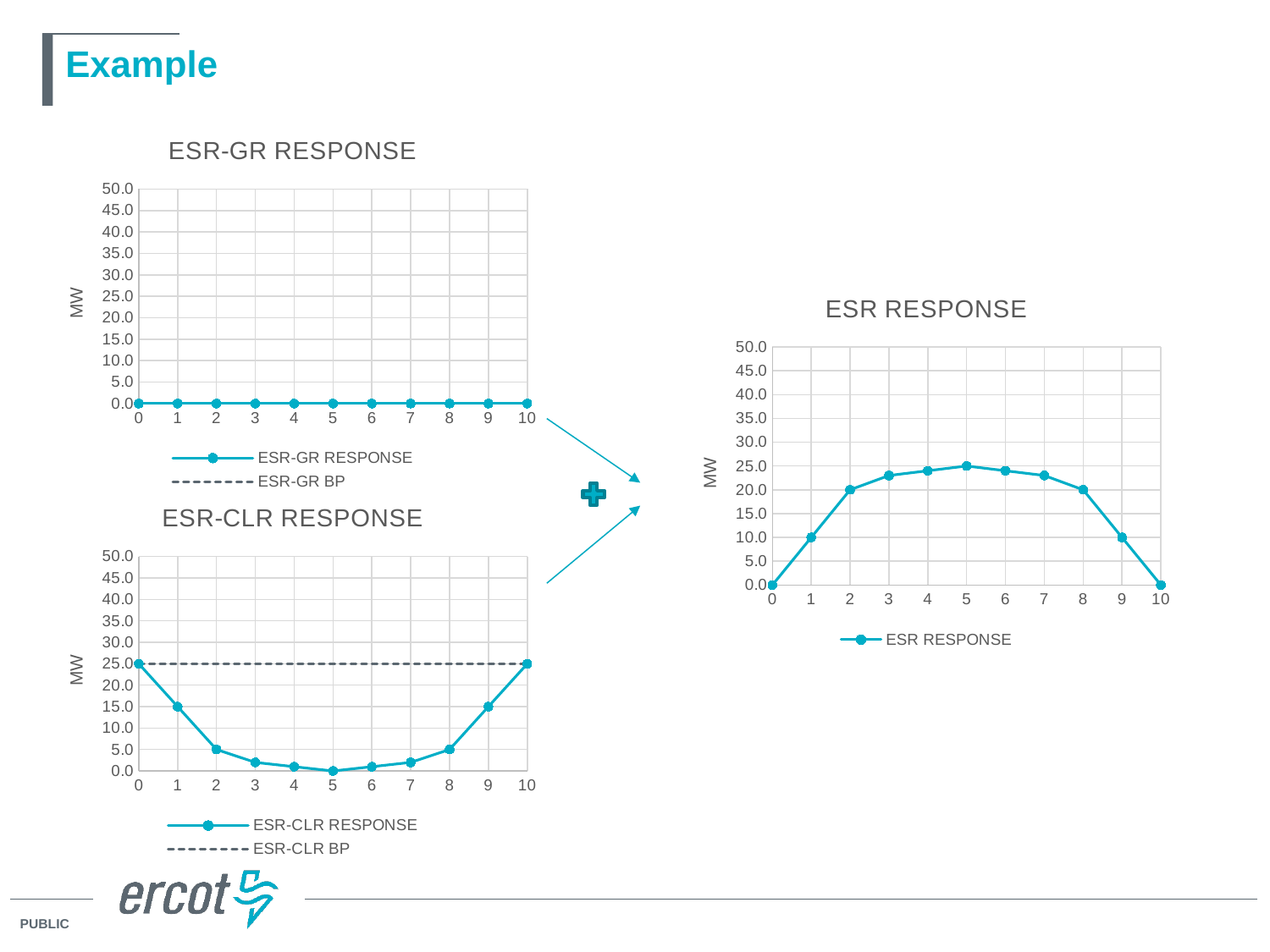
In the ESR-CLR RESPONSE chart, what constant value does the ESR-CLR BP dashed line sit at? 25.0 In the ESR-CLR RESPONSE chart, what is the value of ESR-CLR RESPONSE at x = 5? 0.0 How many series does the legend of the ESR-CLR RESPONSE chart list? 2 In the ESR-CLR RESPONSE chart, does the ESR-CLR RESPONSE line rise or fall from x = 0 to x = 5? fall How many data points are plotted on the ESR RESPONSE line in the ESR RESPONSE chart? 11 What kind of chart is the ESR RESPONSE chart on the right of the slide? line chart In the ESR RESPONSE chart, what is the value of ESR RESPONSE at x = 5? 25.0 In the ESR-CLR RESPONSE chart, what is the value of ESR-CLR RESPONSE at x = 0? 25.0 In the ESR RESPONSE chart, is the value of ESR RESPONSE at x = 3 greater or less than 20.0? greater In the ESR-GR RESPONSE chart, what is the value of ESR-GR RESPONSE at x = 5? 0.0 How many series does the legend of the ESR RESPONSE chart list? 1 In the ESR RESPONSE chart, at which x value is ESR RESPONSE highest? 5